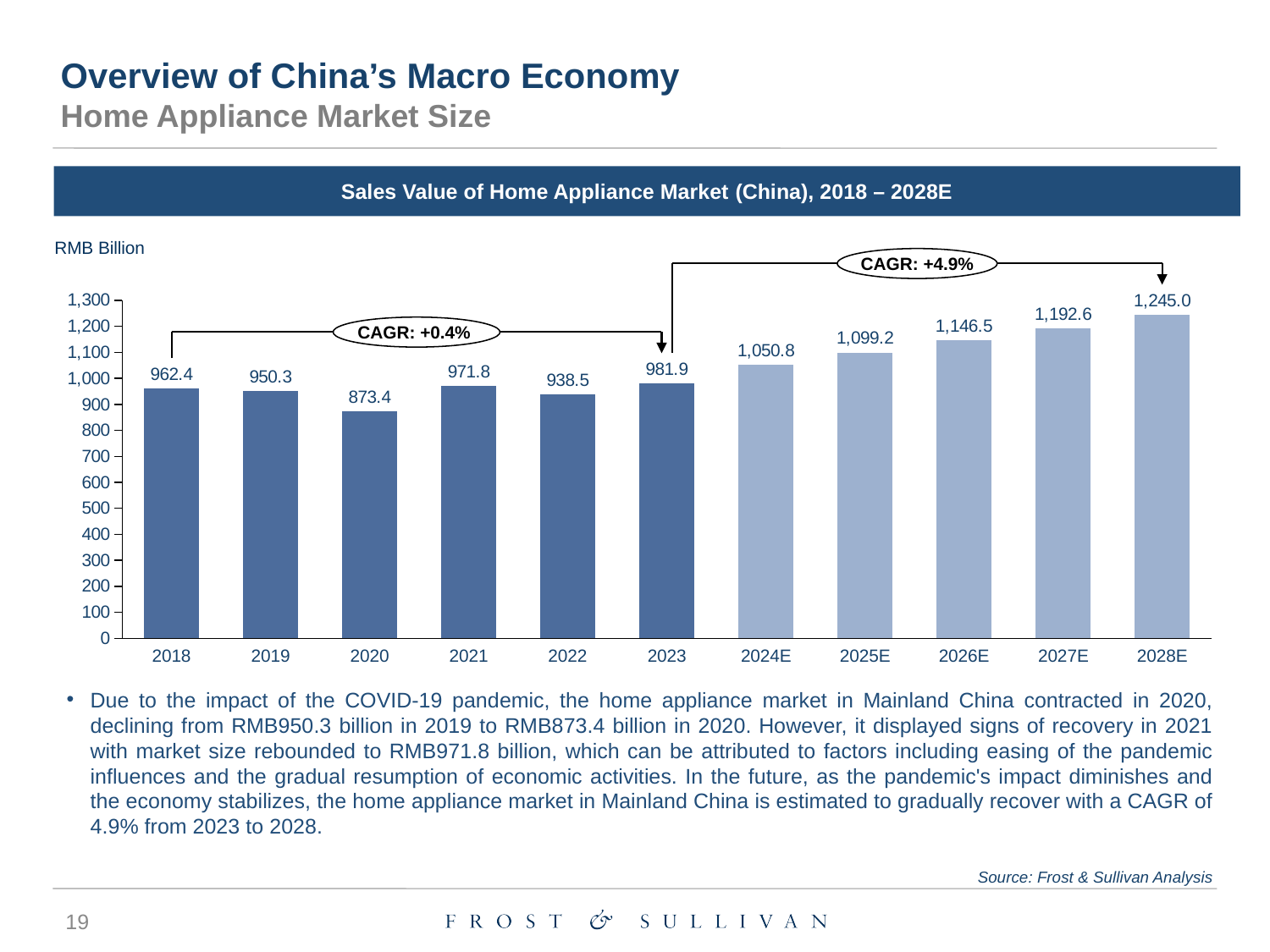
What is the difference between the 2019 and 2020 values? 76.9 Which is larger, the value for 2021 or the value for 2022? 2021 Do the values rise or fall from 2023 to 2028E? Rise What is the sales value of the home appliance market in 2020? 873.4 What is the sales value shown for 2028E? 1,245.0 What is the value for 2023? 981.9 How many years are shown on the x axis? 11 Which year has the highest sales value? 2028E Which year has the lowest sales value? 2020 What kind of chart is this? Bar chart What is the difference between the 2028E and 2023 values? 263.1 What CAGR is shown for the period 2023 to 2028E? +4.9%